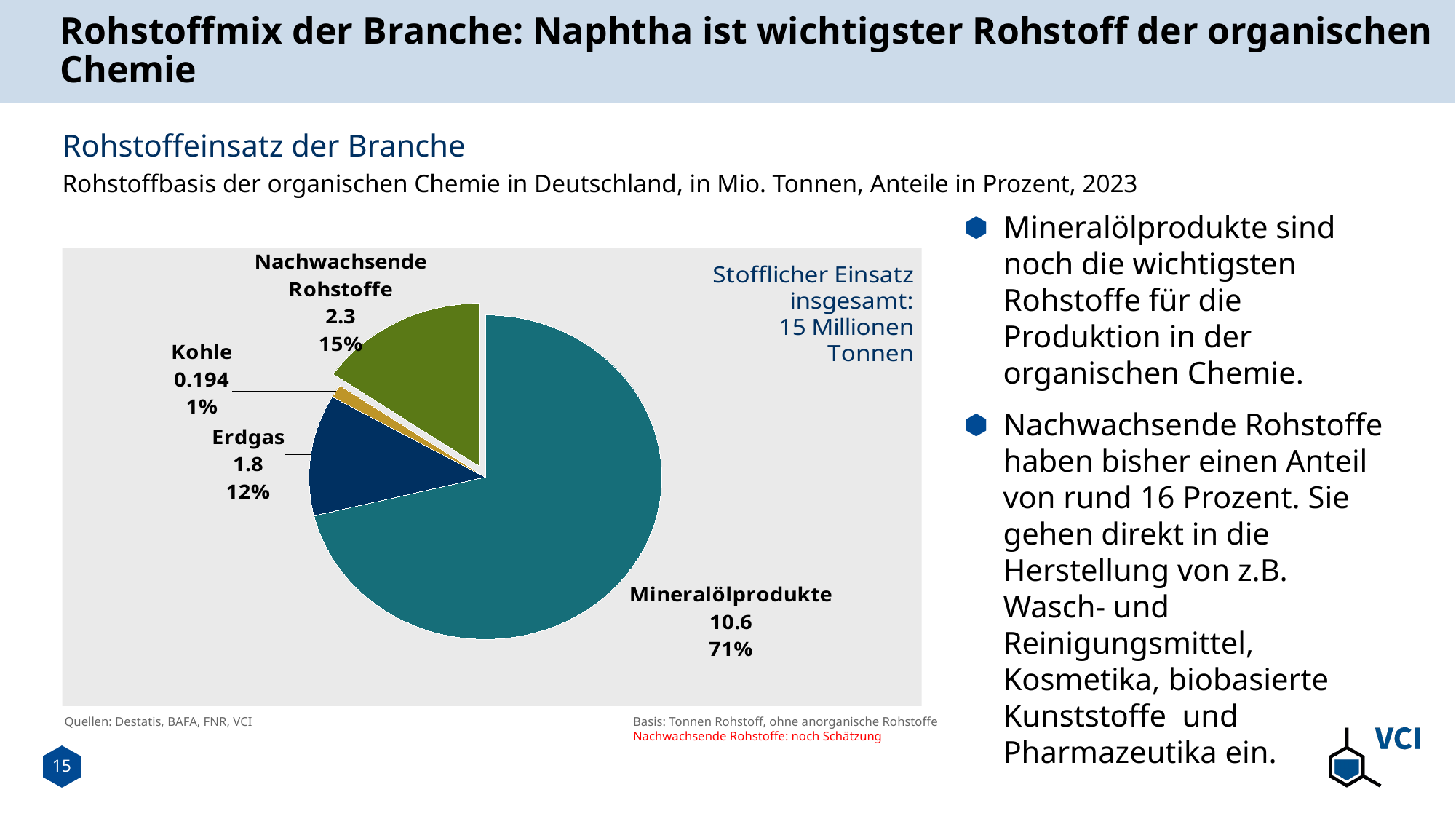
What is the value shown for Kohle in the pie chart? 0.194 Which is larger in the pie chart, Erdgas or Nachwachsende Rohstoffe? Nachwachsende Rohstoffe What percentage share do Nachwachsende Rohstoffe have in the pie chart? 15% What is the value shown for Mineralölprodukte in the pie chart? 10.6 What kind of chart is shown on the slide? pie chart What percentage share does Erdgas have in the pie chart? 12% How many slices does the pie chart have? 4 What is the title of the chart on the slide? Rohstoffeinsatz der Branche What is the difference between the values for Nachwachsende Rohstoffe and Erdgas in the pie chart? 0.5 What total material input (Stofflicher Einsatz insgesamt) is stated on the chart? 15 Millionen Tonnen Which category has the smallest slice in the pie chart? Kohle Which category has the largest slice in the pie chart? Mineralölprodukte